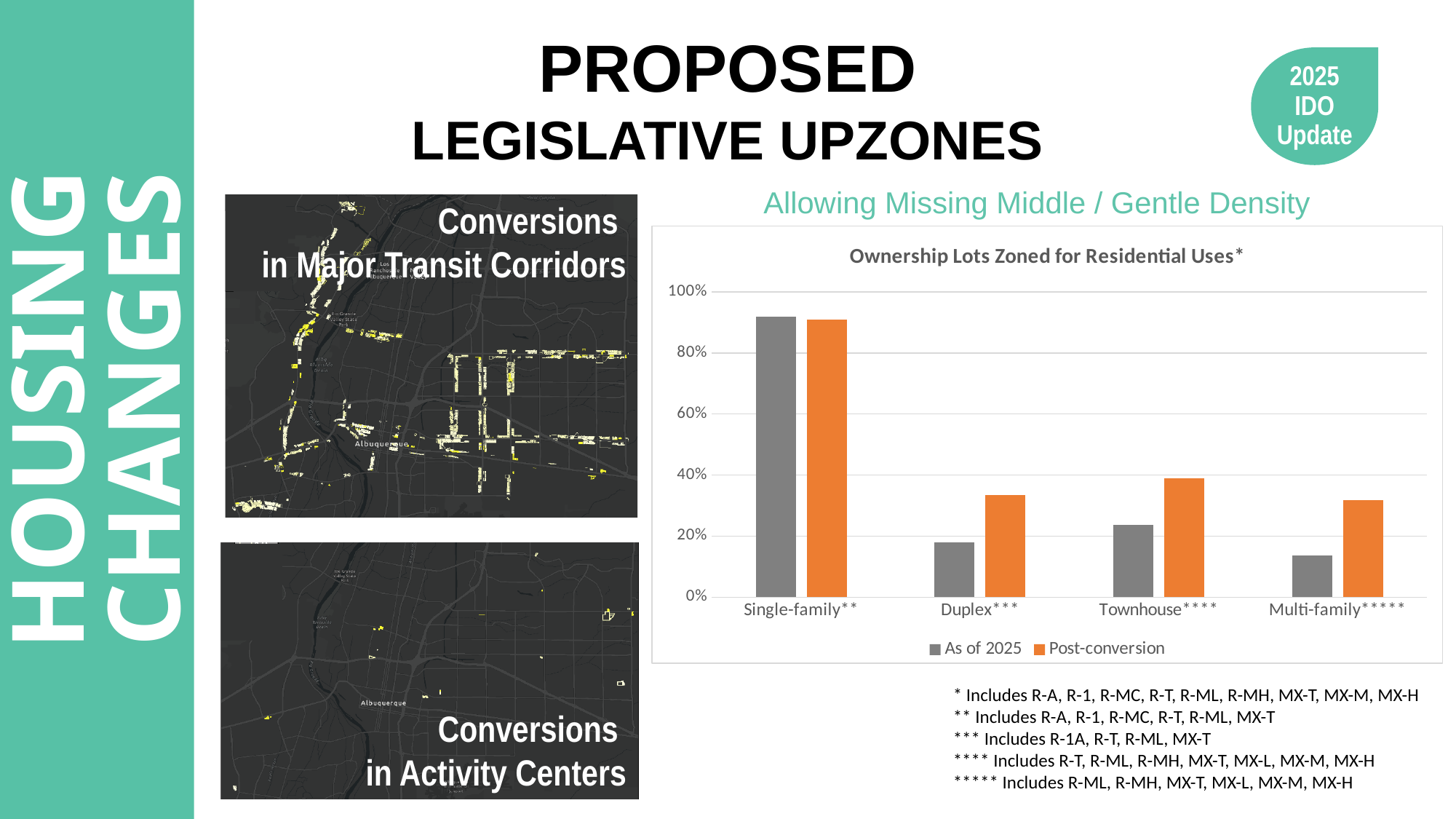
In the 'Ownership Lots Zoned for Residential Uses*' chart, is the 'As of 2025' value for Single-family** greater or less than 80%? greater Which category has the highest 'As of 2025' value in the 'Ownership Lots Zoned for Residential Uses*' chart? Single-family** In the 'Ownership Lots Zoned for Residential Uses*' chart, which is larger: the 'Post-conversion' value for Townhouse**** or the 'Post-conversion' value for Duplex***? Townhouse**** How many series does the legend of the 'Ownership Lots Zoned for Residential Uses*' chart list? 2 How many categories are shown on the x axis of the 'Ownership Lots Zoned for Residential Uses*' chart? 4 Which category has the lowest 'As of 2025' value in the 'Ownership Lots Zoned for Residential Uses*' chart? Multi-family***** What colour are the 'Post-conversion' bars in the 'Ownership Lots Zoned for Residential Uses*' chart? orange What kind of chart is shown under the title 'Ownership Lots Zoned for Residential Uses*'? bar chart Which category has the highest 'Post-conversion' value in the 'Ownership Lots Zoned for Residential Uses*' chart? Single-family** In the 'Ownership Lots Zoned for Residential Uses*' chart, which is larger for Townhouse****: the 'As of 2025' value or the 'Post-conversion' value? Post-conversion In the 'Ownership Lots Zoned for Residential Uses*' chart, is the 'Post-conversion' value for Multi-family***** greater or less than 20%? greater In the 'Ownership Lots Zoned for Residential Uses*' chart, is the 'As of 2025' value for Duplex*** greater or less than 20%? less